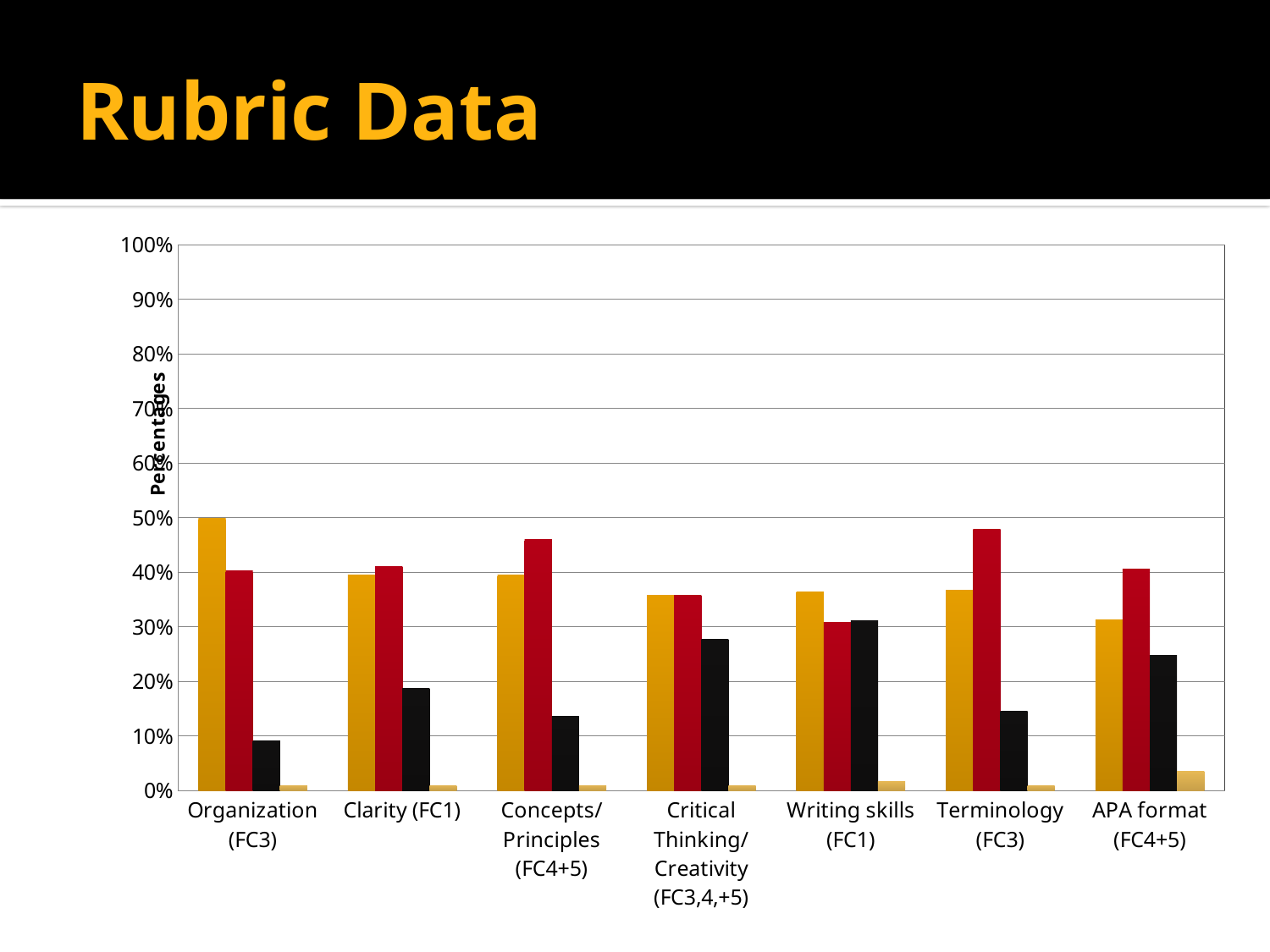
Is the red (second) bar for Terminology (FC3) greater or less than 40%? greater Is the black (third) bar for APA format (FC4+5) greater or less than 30%? less Among the black (third) bars, which category has the lowest value? Organization (FC3) How many bars are plotted for each category in the chart? 4 Is the black (third) bar for Concepts/Principles (FC4+5) greater or less than 20%? less What is the title of the vertical axis of the chart? Percentages How many categories are shown along the x axis of the chart? 7 Among the gold (first) bars, which category has the highest value? Organization (FC3) What kind of chart is shown on the slide? bar chart For Writing skills (FC1), which is larger: the gold (first) bar or the red (second) bar? the gold bar For Terminology (FC3), which is larger: the gold (first) bar or the red (second) bar? the red bar